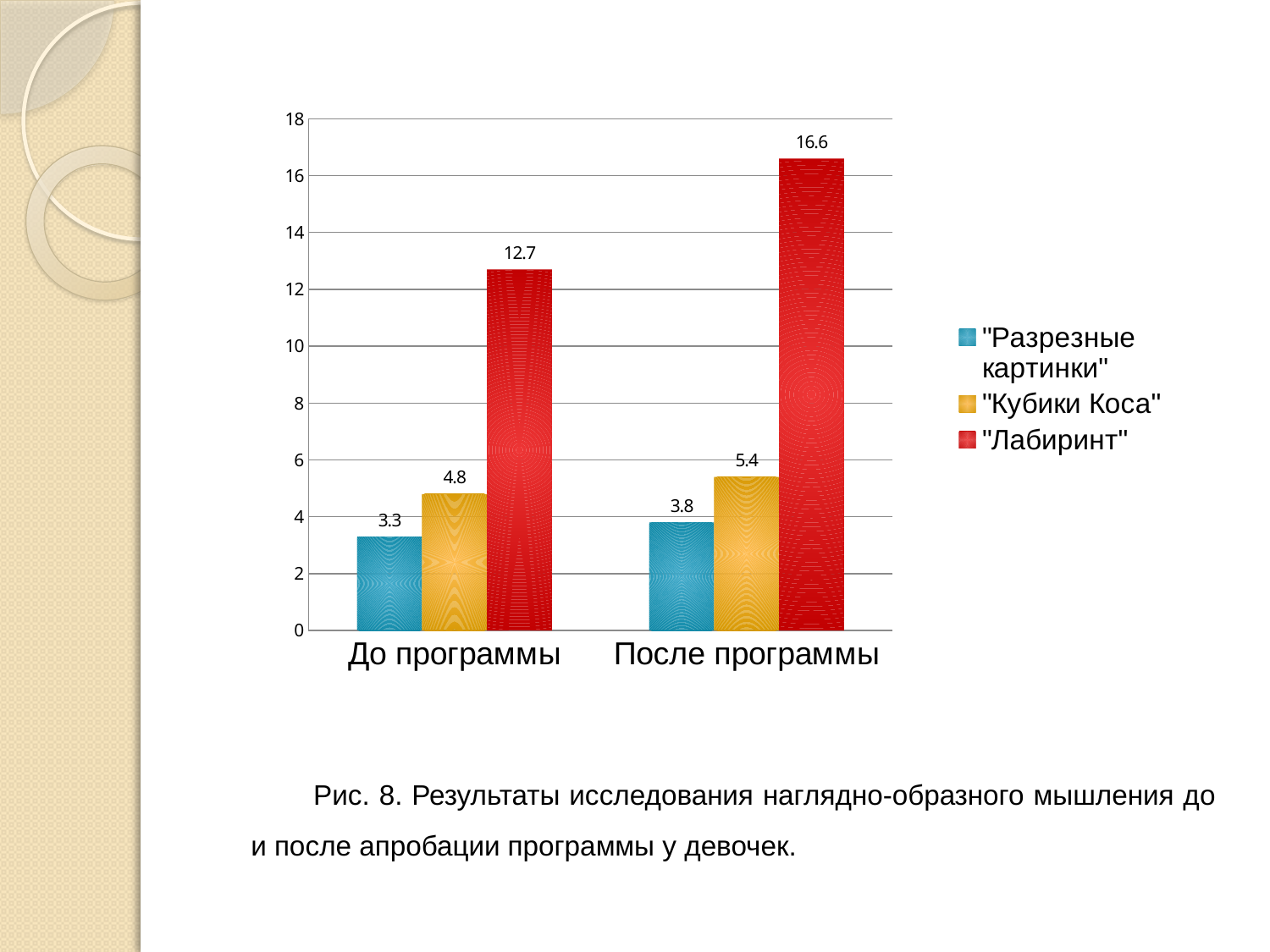
How many series does the legend list? 3 Which series has the lowest value in the "После программы" category? "Разрезные картинки" What is the value for "Разрезные картинки" in the "До программы" category? 3.3 How many categories are shown on the x axis? 2 Is the value for "Лабиринт" in "До программы" greater or less than 12? greater What is the value for "Лабиринт" in the "После программы" category? 16.6 What is the value for "Кубики Коса" in the "После программы" category? 5.4 Which is larger: "Кубики Коса" in "До программы" or "Кубики Коса" in "После программы"? "После программы" What kind of chart is shown on the slide? bar chart Which series has the highest value in the "До программы" category? "Лабиринт" What is the difference between the "Лабиринт" values for "После программы" and "До программы"? 3.9 What colour represents the "Лабиринт" series? red